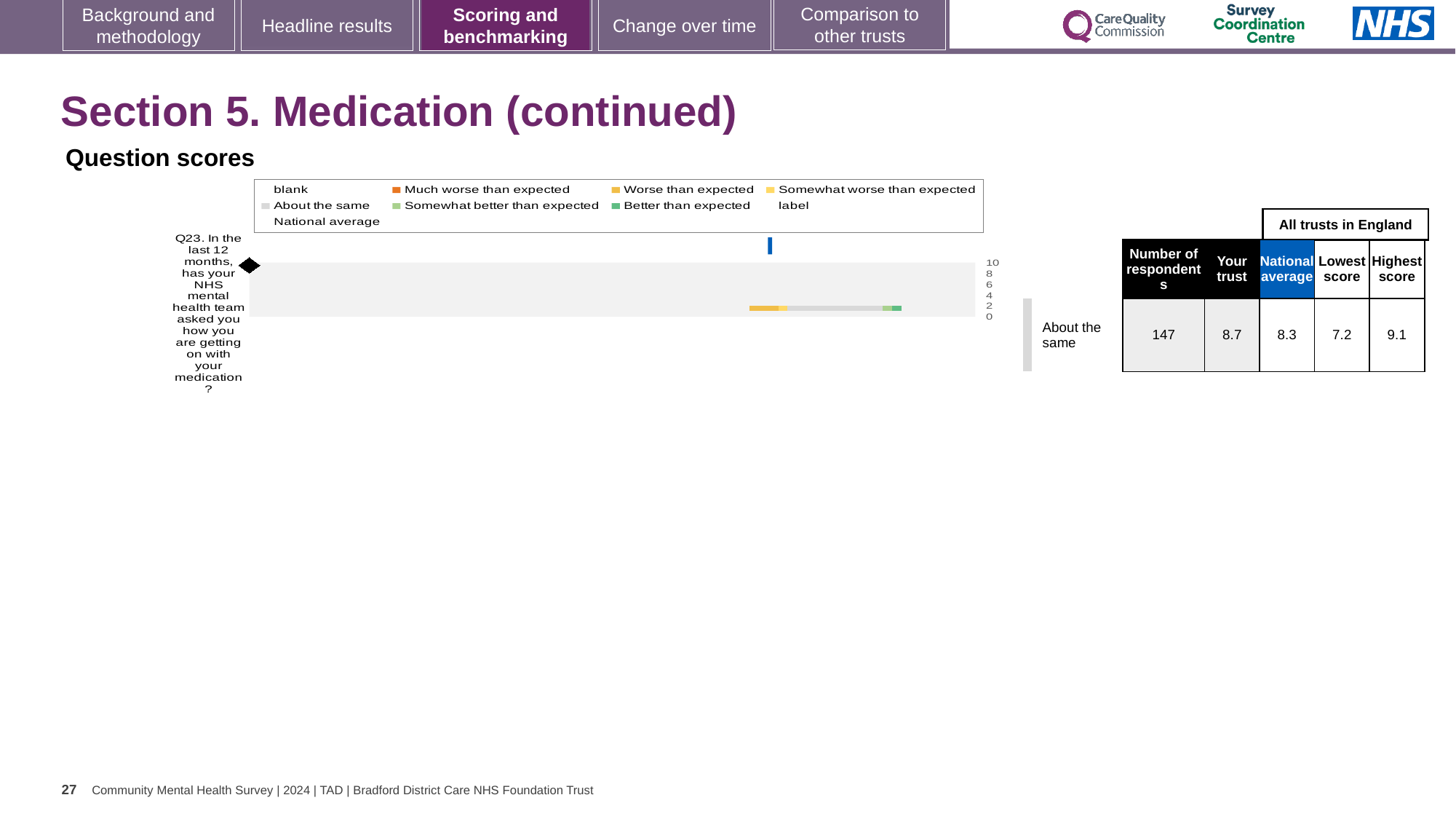
By how much does the 'Your trust' score for Q23 exceed the national average? 0.4 What is the highest tick value shown on the chart's score axis? 10 What is the 'Your trust' score for Q23 shown in the table next to the chart? 8.7 What kind of chart is shown under 'Question scores'? bar chart What is the lowest score among all trusts in England for Q23? 7.2 What benchmarking category is given for Q23 next to the chart? About the same What is the difference between the highest score and the lowest score for Q23? 1.9 What is the highest score among all trusts in England for Q23? 9.1 For Q23, which is larger: the 'Your trust' score or the national average? Your trust How many respondents answered Q23? 147 What is the national average score for Q23 shown in the table? 8.3 How many survey questions are plotted in the Question scores chart? 1